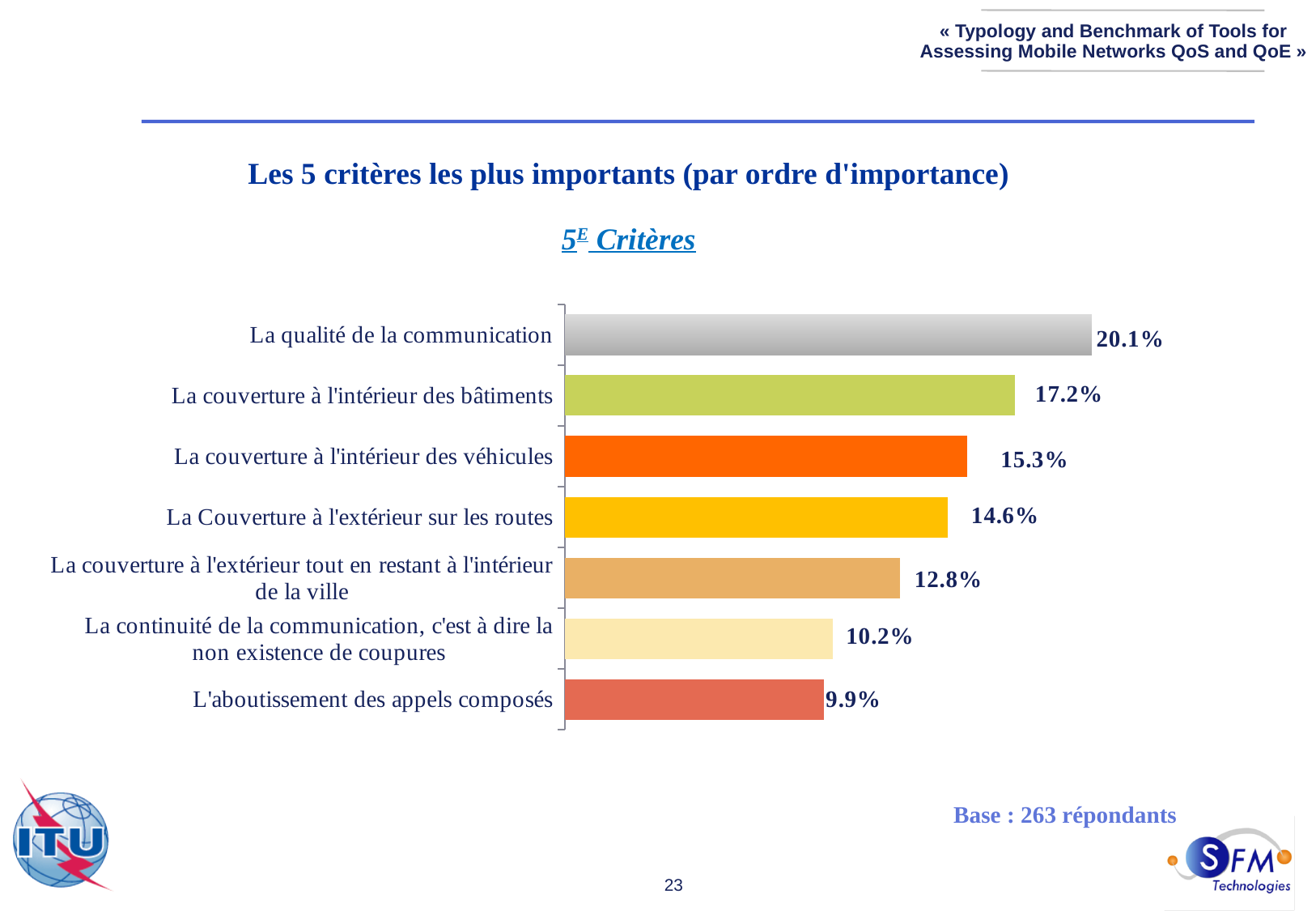
What kind of chart is shown on the slide? Bar chart What is the value for "L'aboutissement des appels composés"? 9.9% How many respondents form the base of the chart? 263 How many categories are shown in the chart? 7 What is the value for "La couverture à l'intérieur des véhicules"? 15.3% What is the value for "La qualité de la communication"? 20.1% Which is larger: "La couverture à l'intérieur des véhicules" or "La Couverture à l'extérieur sur les routes"? La couverture à l'intérieur des véhicules What is the difference between "La qualité de la communication" and "La couverture à l'intérieur des bâtiments"? 2.9% Which category has the lowest value? L'aboutissement des appels composés What is the difference between "La Couverture à l'extérieur sur les routes" and "La couverture à l'extérieur tout en restant à l'intérieur de la ville"? 1.8% What is the value for "La continuité de la communication, c'est à dire la non existence de coupures"? 10.2% Which category has the highest value? La qualité de la communication